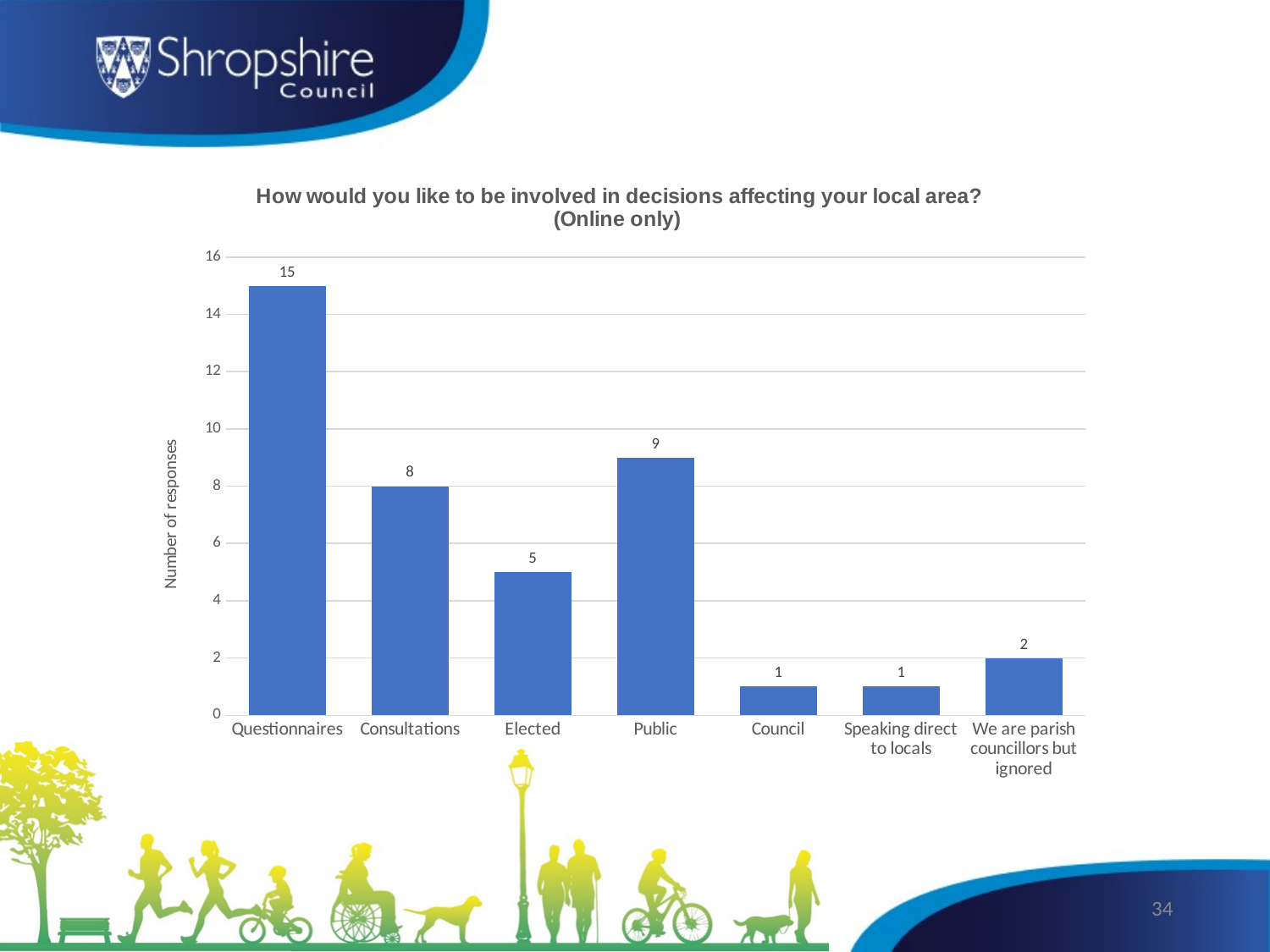
What is the value for 'We are parish councillors but ignored'? 2 How many responses are shown for Questionnaires? 15 Which has more responses, Consultations or Public? Public What type of chart is this? Bar chart Which category has the highest number of responses? Questionnaires How many responses does the Public category have? 9 What is the difference between Consultations and Elected? 3 What is the label of the y axis? Number of responses What is the value for Consultations? 8 What is the difference in responses between Questionnaires and Public? 6 What is the title of the chart? How would you like to be involved in decisions affecting your local area? (Online only) How many categories are shown on the x axis? 7